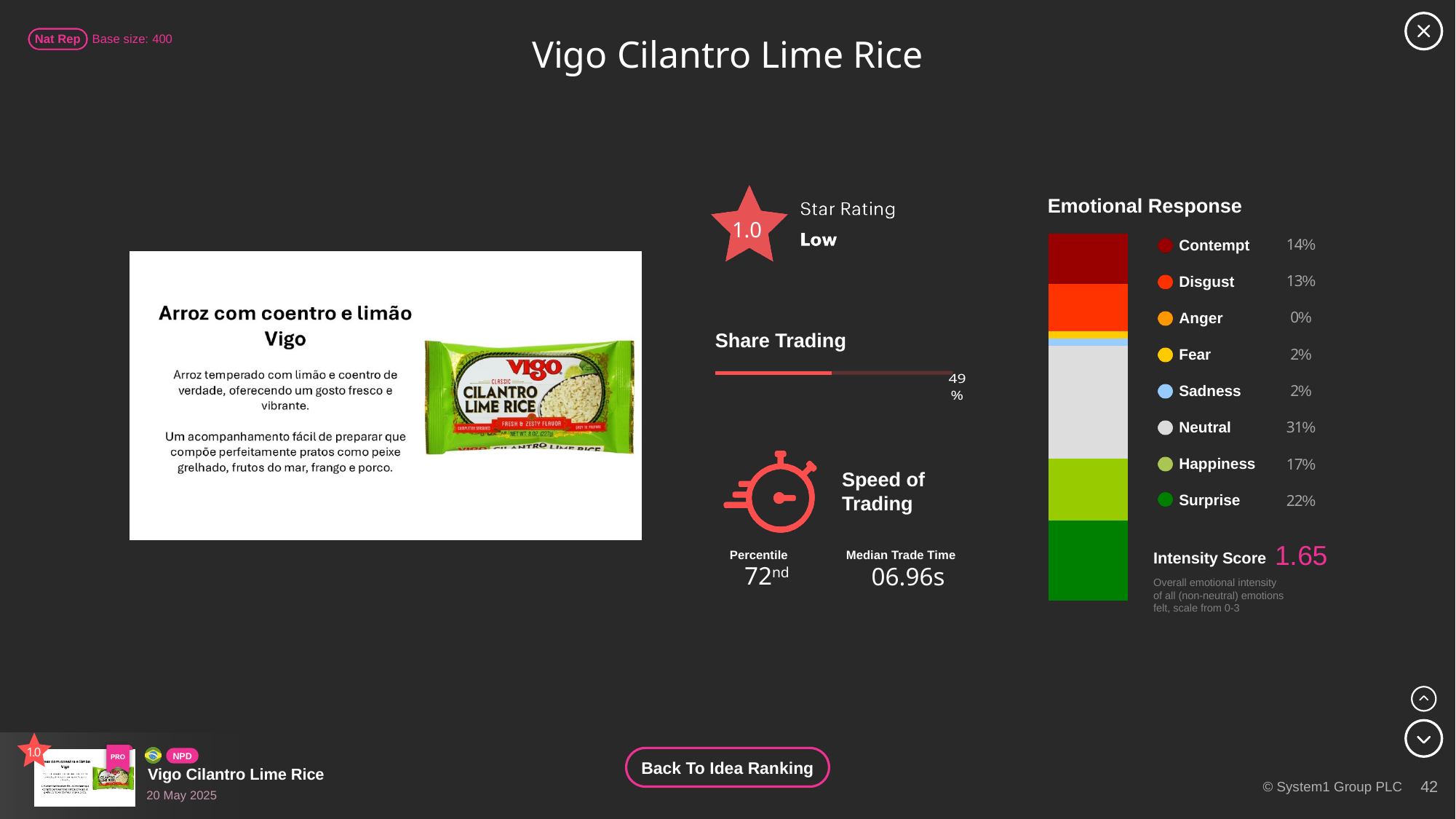
In the Emotional Response chart, what is the difference between the Surprise and Happiness percentages? 5% In the Emotional Response chart, what percentage is shown for Neutral? 31% In the Emotional Response chart, what is the combined percentage of Fear and Sadness? 4% What value is shown on the Share Trading bar? 49% What kind of chart is the Emotional Response chart? Stacked bar chart In the Emotional Response chart, which emotion has the highest percentage? Neutral In the Emotional Response chart, what percentage is shown for Contempt? 14% What colour represents Neutral in the Emotional Response chart? Grey In the Emotional Response chart, which emotion has the lowest percentage? Anger In the Emotional Response chart, what percentage is shown for Surprise? 22% In the Emotional Response chart, which is larger, Contempt or Disgust? Contempt How many emotions are listed in the Emotional Response chart? 8